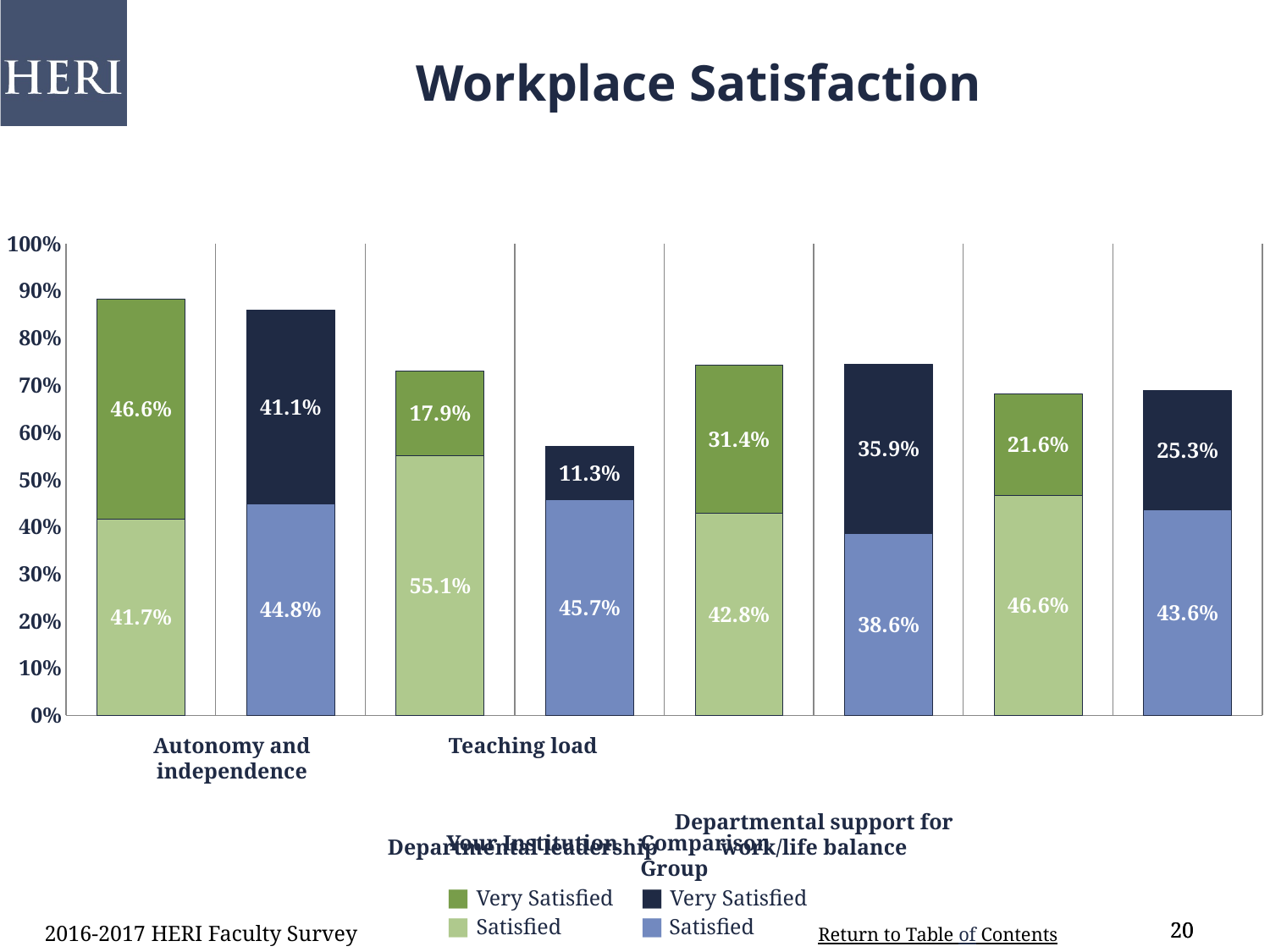
What is the title of the chart? Workplace Satisfaction What is the difference between the Very Satisfied percentages for Your Institution and the Comparison Group on Teaching load? 6.6% What percentage of the Comparison Group is Very Satisfied with Departmental support for work/life balance? 25.3% What is the total percentage (Satisfied plus Very Satisfied) for Your Institution on Teaching load? 73.0% Across the four categories, which has the lowest Very Satisfied percentage for the Comparison Group? Teaching load Which is larger: the Very Satisfied percentage for Your Institution or for the Comparison Group on Departmental leadership? Comparison Group What percentage of Your Institution faculty are Very Satisfied with Autonomy and independence? 46.6% What is the total percentage (Satisfied plus Very Satisfied) for the Comparison Group on Autonomy and independence? 85.9% How many categories are shown on the x axis? 4 What percentage of the Comparison Group is Satisfied with Teaching load? 45.7% What percentage of Your Institution faculty are Satisfied with Departmental leadership? 42.8% What type of chart is shown on the slide? stacked bar chart